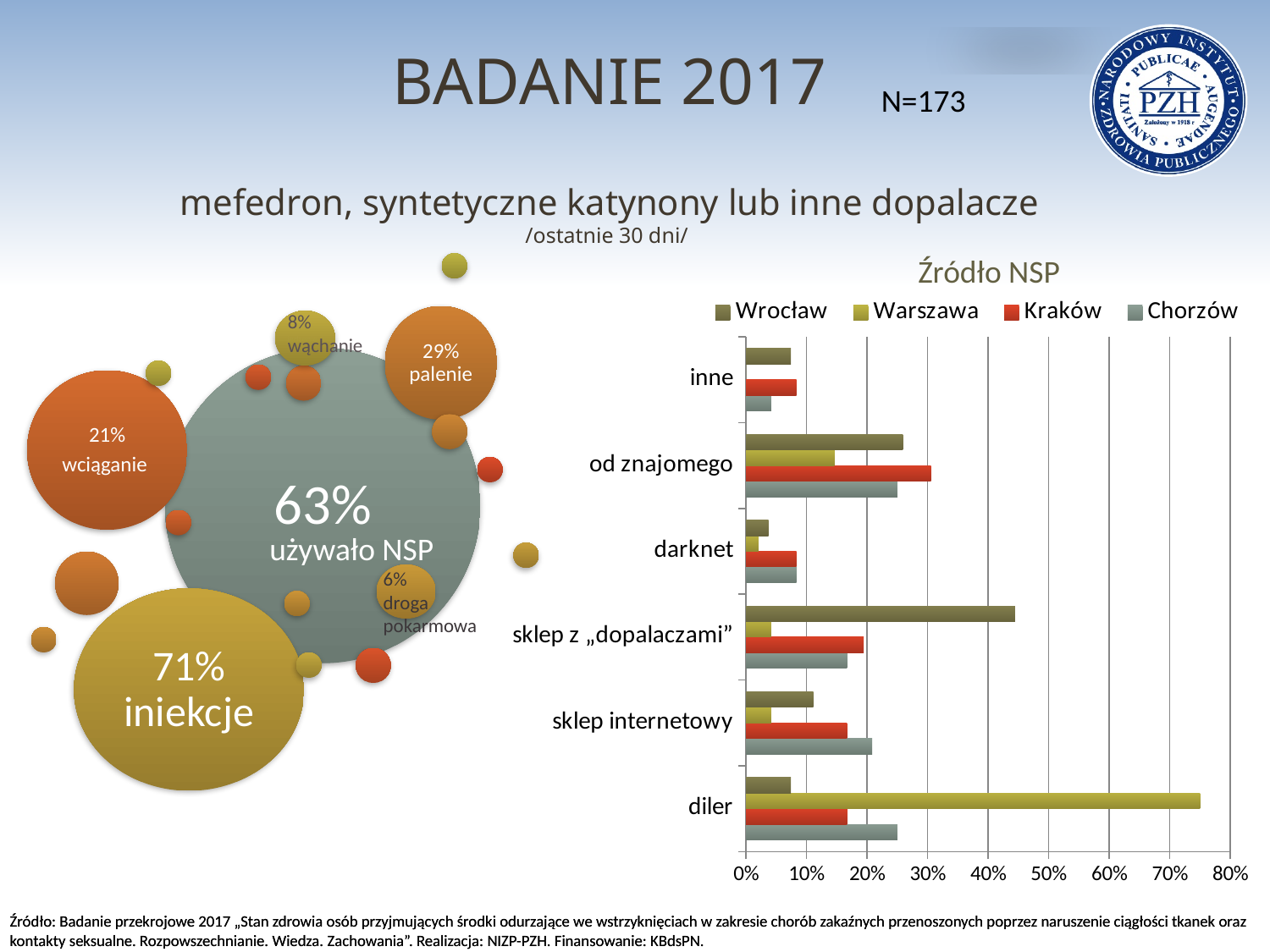
In the "Źródło NSP" chart, which is larger for "sklep z „dopalaczami”": the Wrocław value or the Warszawa value? Wrocław In the "Źródło NSP" chart, which series has the highest value for "diler"? Warszawa In the "Źródło NSP" chart, how many series does the legend list? 4 In the "Źródło NSP" chart, which colour represents the Kraków series? red What kind of chart is the "Źródło NSP" chart? bar chart In the "Źródło NSP" chart, how many categories are shown on the vertical axis? 6 In the "Źródło NSP" chart, for which category is the Warszawa bar the longest? diler In the "Źródło NSP" chart, is the Wrocław value for "sklep z „dopalaczami”" greater or less than 40%? greater In the "Źródło NSP" chart, is the Wrocław value for "darknet" greater or less than 10%? less In the "Źródło NSP" chart, is the Warszawa value for "diler" greater or less than 70%? greater In the bubble graphic on the left, what percentage is shown for "iniekcje"? 71% In the "Źródło NSP" chart, which series has the highest value for "sklep z „dopalaczami”"? Wrocław